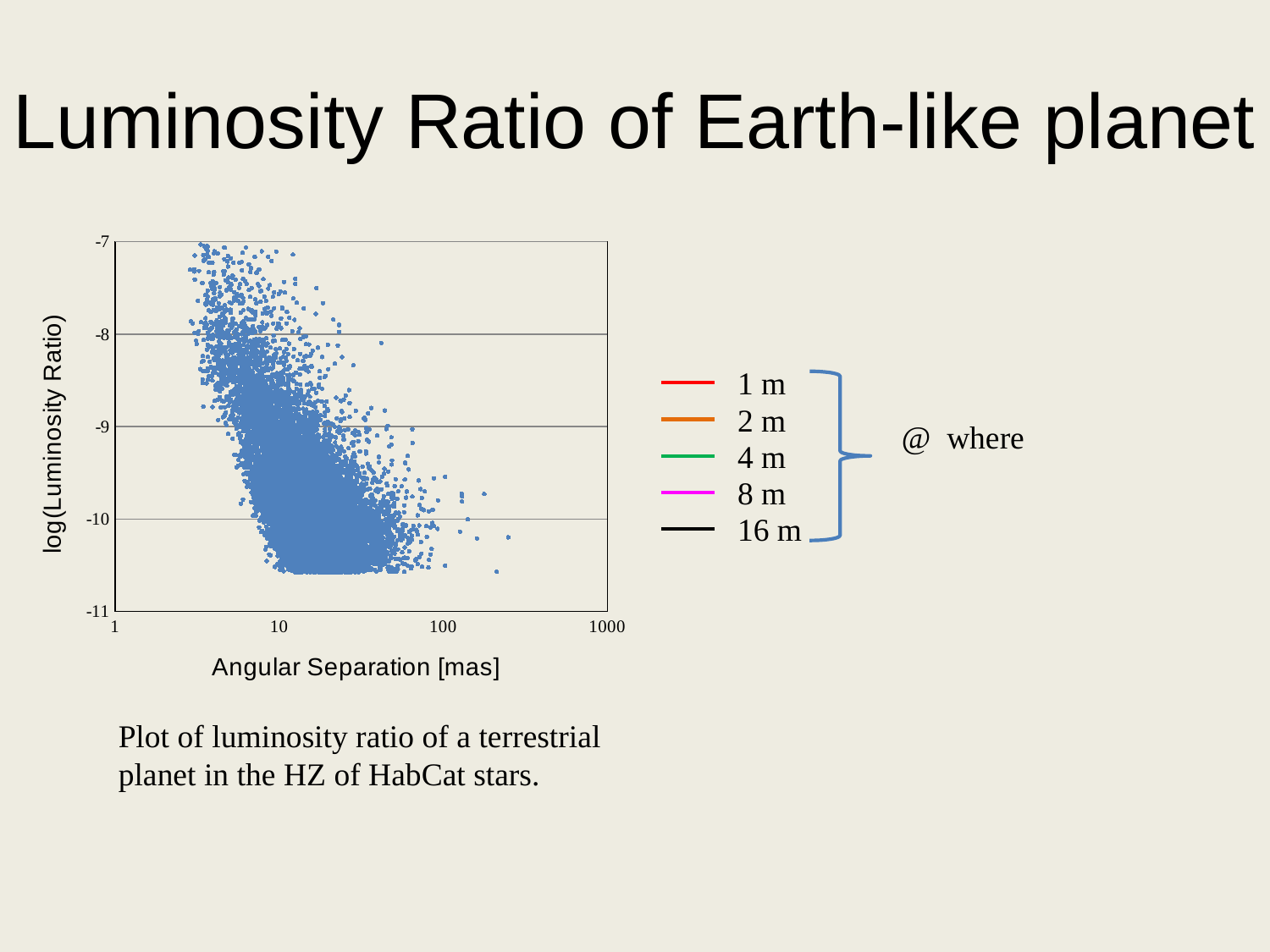
What is the label of the y axis of the chart? log(Luminosity Ratio) What is the largest tick value shown on the x axis of the chart? 1000 What is the label of the x axis of the chart? Angular Separation [mas] What is the highest value shown on the y axis of the chart? -7 How many aperture sizes are listed in the legend to the right of the chart? 5 What kind of chart is shown on the slide? Scatter plot What is the lowest value shown on the y axis of the chart? -11 As angular separation increases along the x axis, do the plotted log(Luminosity Ratio) values generally rise or fall? Fall Is the x axis of the chart on a linear or logarithmic scale? Logarithmic